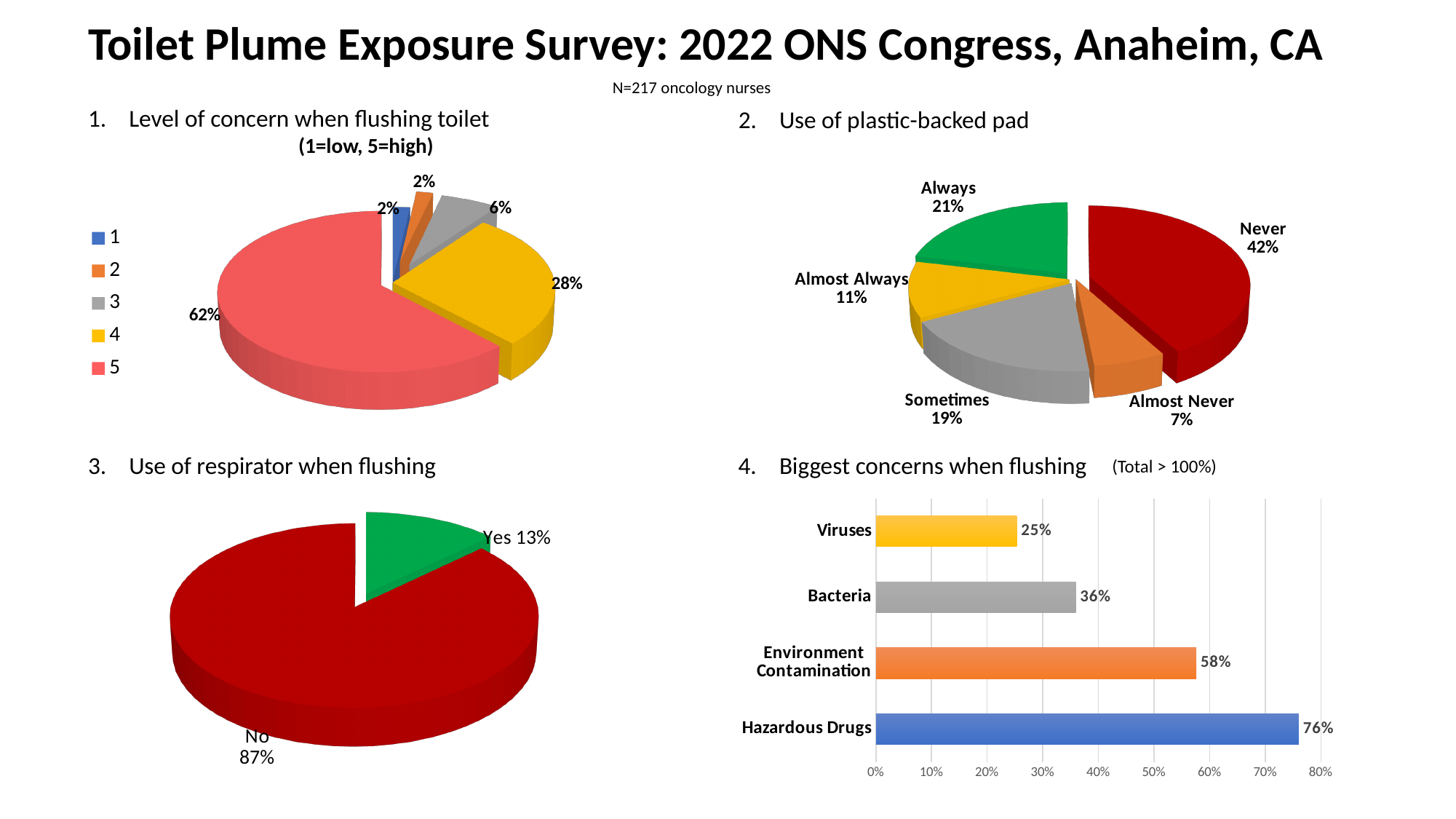
In the 'Level of concern when flushing toilet' pie chart, what percentage of nurses rated their concern as 5? 62% What kind of chart is used for 'Use of respirator when flushing'? Pie chart In the 'Use of respirator when flushing' pie chart, what percentage answered 'No'? 87% In the 'Level of concern when flushing toilet' pie chart, which rating has the largest share? 5 In the 'Biggest concerns when flushing' chart, what is the difference between Hazardous Drugs and Environment Contamination? 18% In the 'Use of plastic-backed pad' pie chart, which response has the smallest share? Almost Never In the 'Biggest concerns when flushing' chart, what is the value for Bacteria? 36% What kind of chart is used for 'Biggest concerns when flushing'? Bar chart In the 'Level of concern when flushing toilet' pie chart, how many entries does the legend list? 5 In the 'Biggest concerns when flushing' chart, which concern has the highest value? Hazardous Drugs In the 'Use of plastic-backed pad' pie chart, what is the difference between the 'Always' and 'Almost Always' shares? 10% In the 'Use of plastic-backed pad' pie chart, what percentage answered 'Never'? 42%